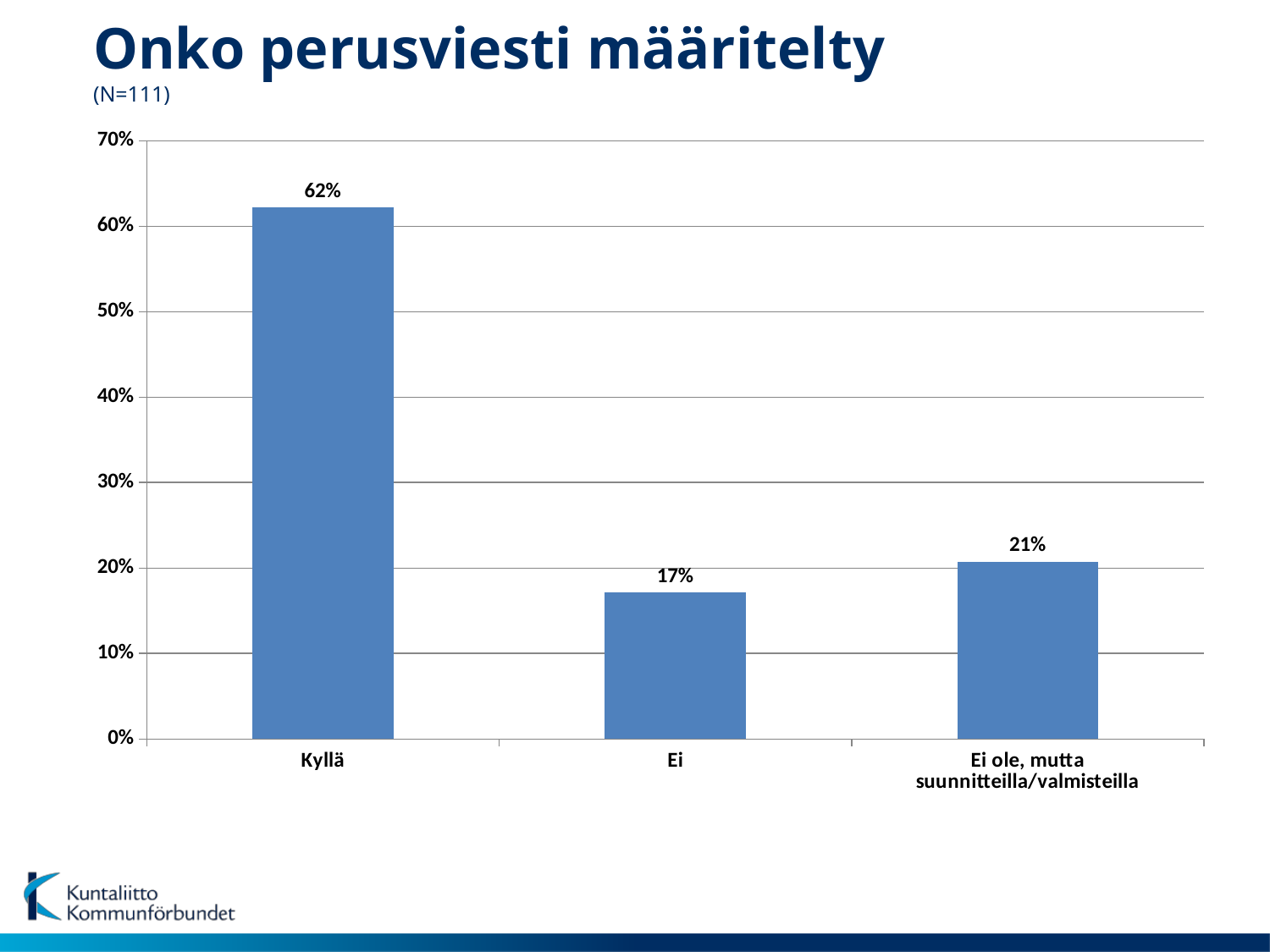
Which category has the lowest value? Ei What is the sample size (N) stated under the chart title? N=111 How many categories are shown on the x axis? 3 What is the difference between the values for 'Ei ole, mutta suunnitteilla/valmisteilla' and Ei? 4% What is the value for 'Ei ole, mutta suunnitteilla/valmisteilla'? 21% What kind of chart is shown on the slide? bar chart Is the value for Kyllä greater or less than 50%? greater What is the value for Ei? 17% What is the value for Kyllä? 62% What is the difference between the values for Kyllä and Ei? 45% Which is larger, the value for Ei or the value for 'Ei ole, mutta suunnitteilla/valmisteilla'? Ei ole, mutta suunnitteilla/valmisteilla Which category has the highest value? Kyllä